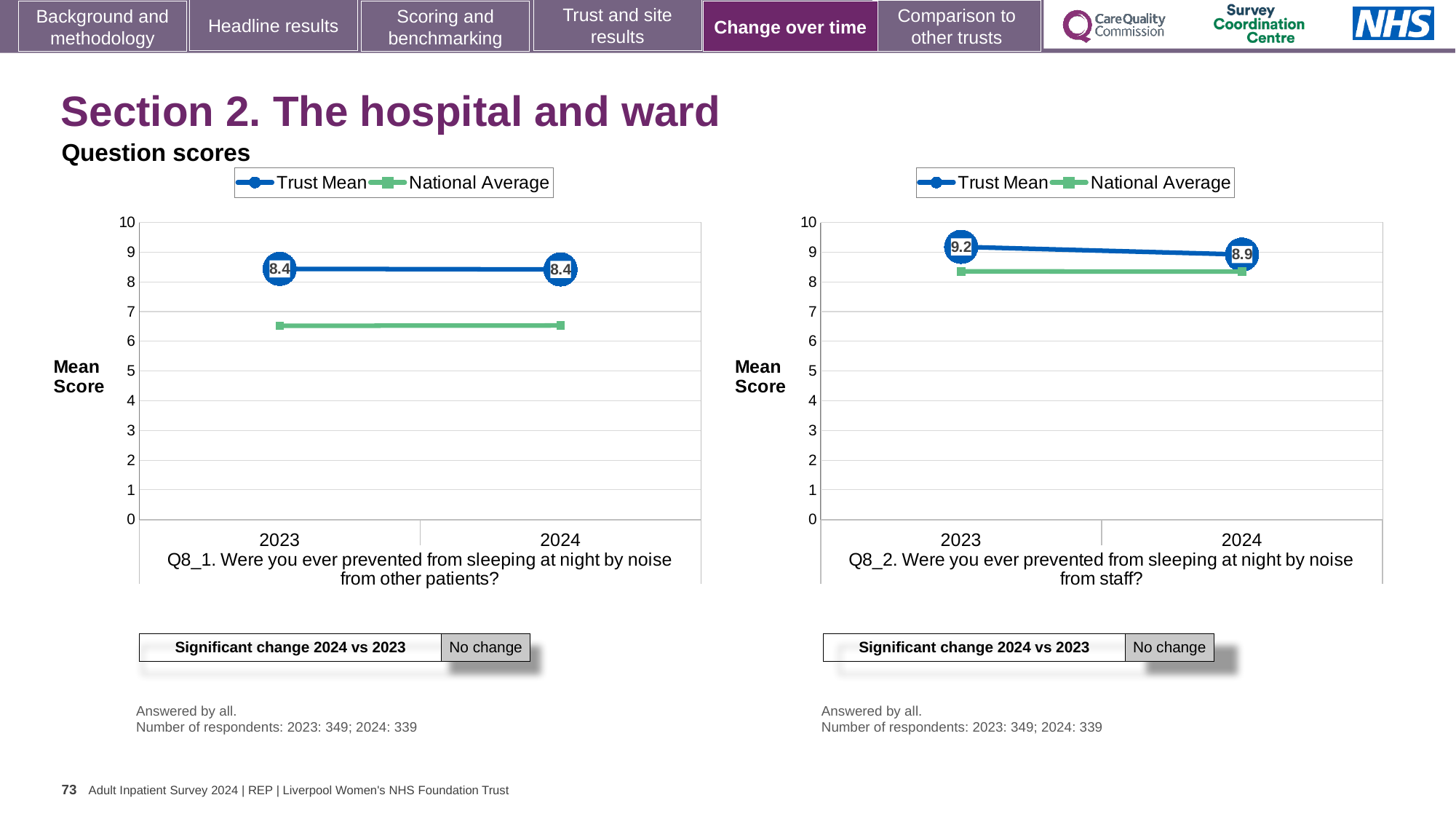
In the Q8_2 chart (right), what is the Trust Mean score for 2023? 9.2 In the Q8_2 chart (right), does the Trust Mean rise or fall from 2023 to 2024? fall In the Q8_1 chart (left), which series is higher in 2024, Trust Mean or National Average? Trust Mean In the Q8_1 chart (left), what is the Trust Mean score for 2024? 8.4 What kind of chart is the Q8_1 chart (left)? line chart In the Q8_2 chart (right), is the National Average value for 2024 greater or less than 8? greater In the Q8_2 chart (right), what is the Trust Mean score for 2024? 8.9 How many series does the legend of the Q8_2 chart (right) list? 2 In the Q8_2 chart (right), what is the difference between the Trust Mean scores for 2023 and 2024? 0.3 How many years are plotted on the x axis of the Q8_2 chart (right)? 2 In the Q8_1 chart (left), what is the Trust Mean score for 2023? 8.4 In the Q8_1 chart (left), is the National Average value for 2023 greater or less than 7? less